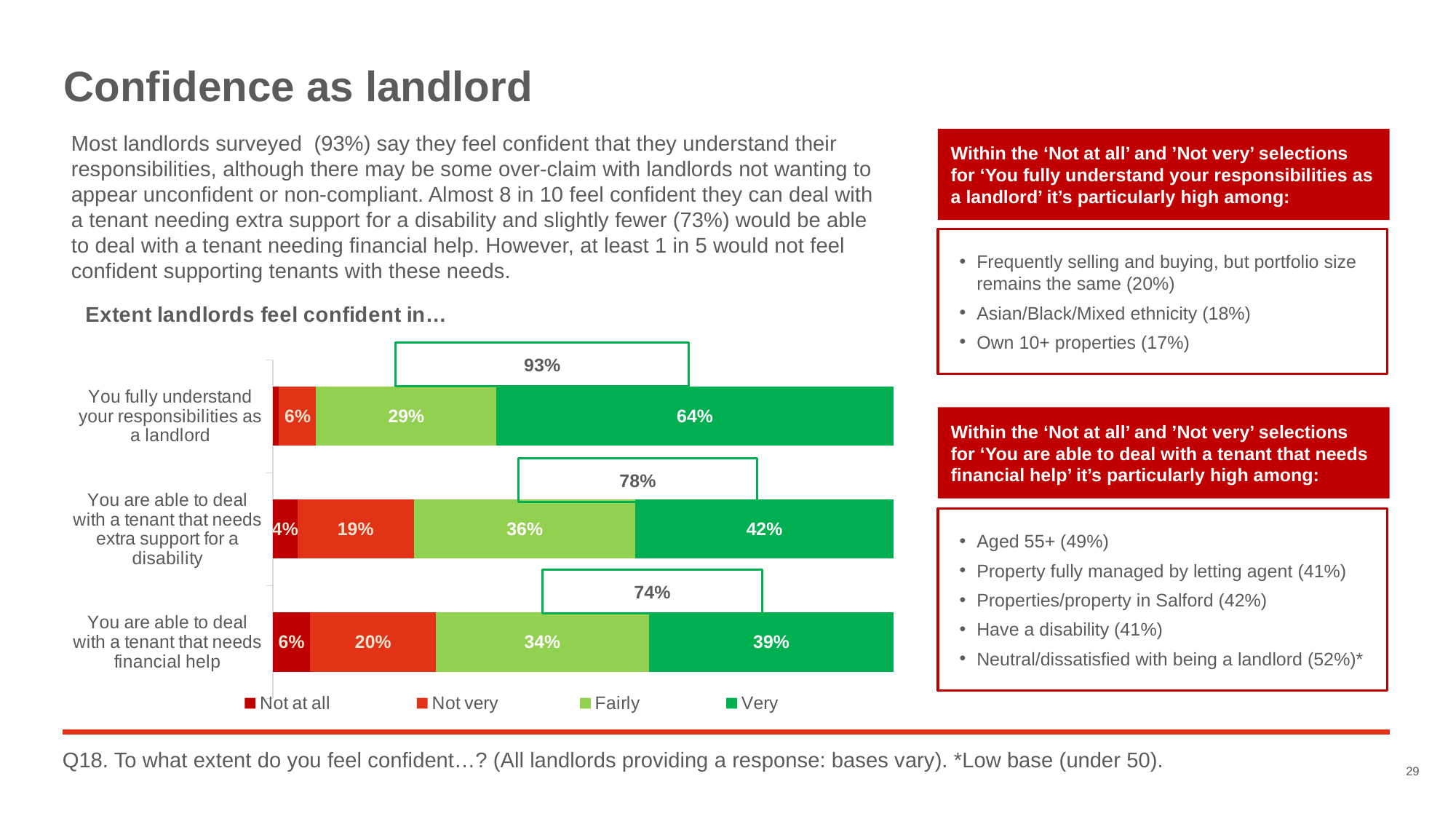
What combined 'Fairly' plus 'Very' percentage is shown above the bar for 'You are able to deal with a tenant that needs extra support for a disability'? 78% How many series does the legend list? 4 Which statement has the highest 'Very' value? You fully understand your responsibilities as a landlord Which is larger: the 'Fairly' value for 'You are able to deal with a tenant that needs extra support for a disability' or the 'Fairly' value for 'You are able to deal with a tenant that needs financial help'? You are able to deal with a tenant that needs extra support for a disability What is the 'Fairly' value for 'You are able to deal with a tenant that needs extra support for a disability'? 36% What is the 'Very' value for 'You fully understand your responsibilities as a landlord'? 64% How many categories (statements) are plotted on the chart? 3 What is the 'Not at all' value for 'You are able to deal with a tenant that needs extra support for a disability'? 4% What is the 'Not very' value for 'You are able to deal with a tenant that needs financial help'? 20% Which statement has the lowest 'Very' value? You are able to deal with a tenant that needs financial help What kind of chart is shown under 'Extent landlords feel confident in…'? Stacked bar chart What is the difference between the 'Very' values for 'You fully understand your responsibilities as a landlord' and 'You are able to deal with a tenant that needs financial help'? 25%